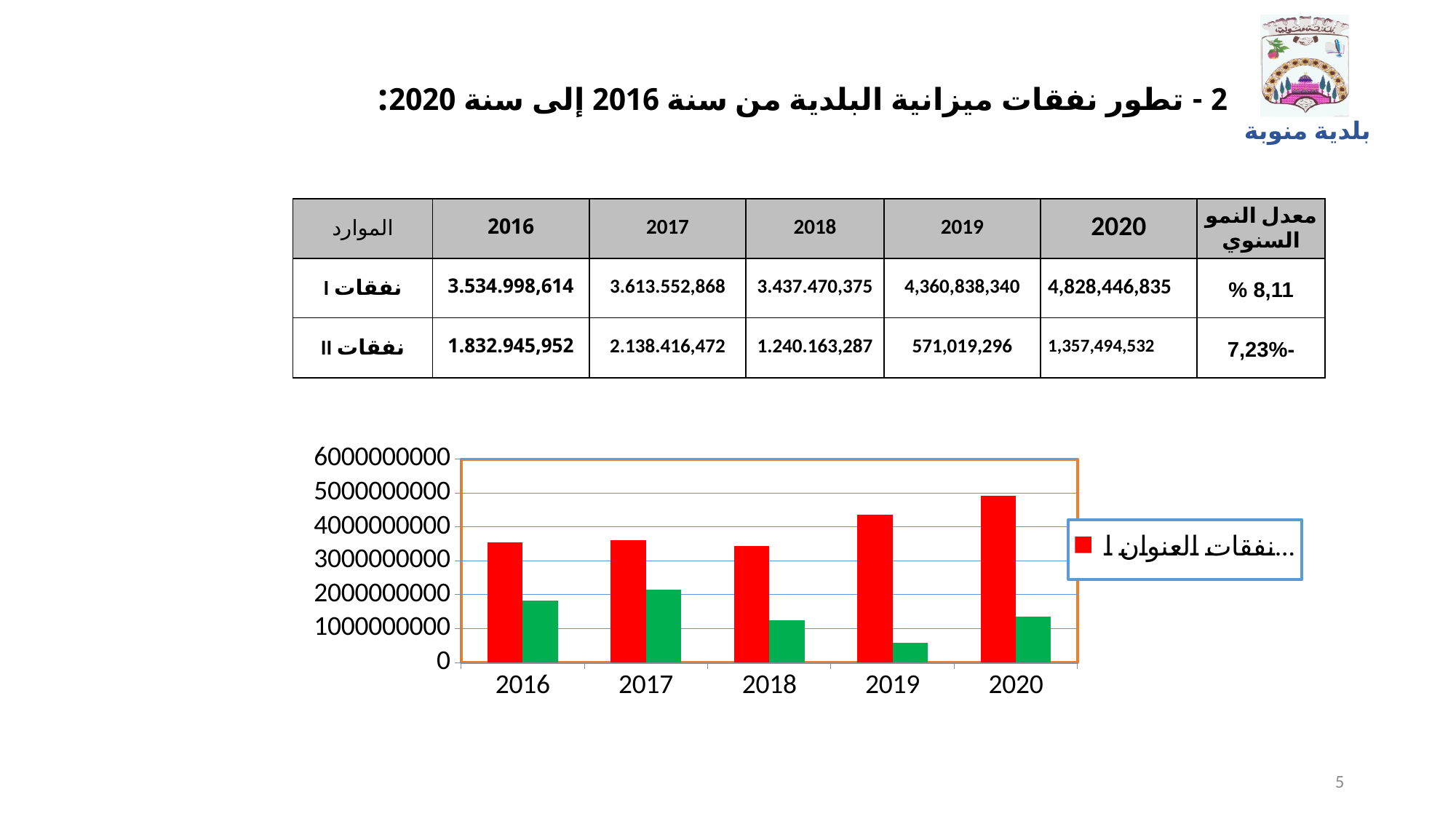
How many bars are plotted for each year in the chart? 2 What colour is the series shown in the chart legend? red Is the green bar for 2019 greater or less than 1000000000? less In which year is the red bar the tallest? 2020 Do the red bars rise or fall from 2018 to 2020? rise Which is larger in the chart: the red bar for 2016 or the red bar for 2020? 2020 In which year is the green bar the tallest? 2017 Is the red bar for 2020 greater or less than 4000000000? greater Is the red bar for 2018 greater or less than 4000000000? less What kind of chart is shown on the slide? bar chart In which year is the green bar the shortest? 2019 How many years are shown on the x axis of the chart? 5